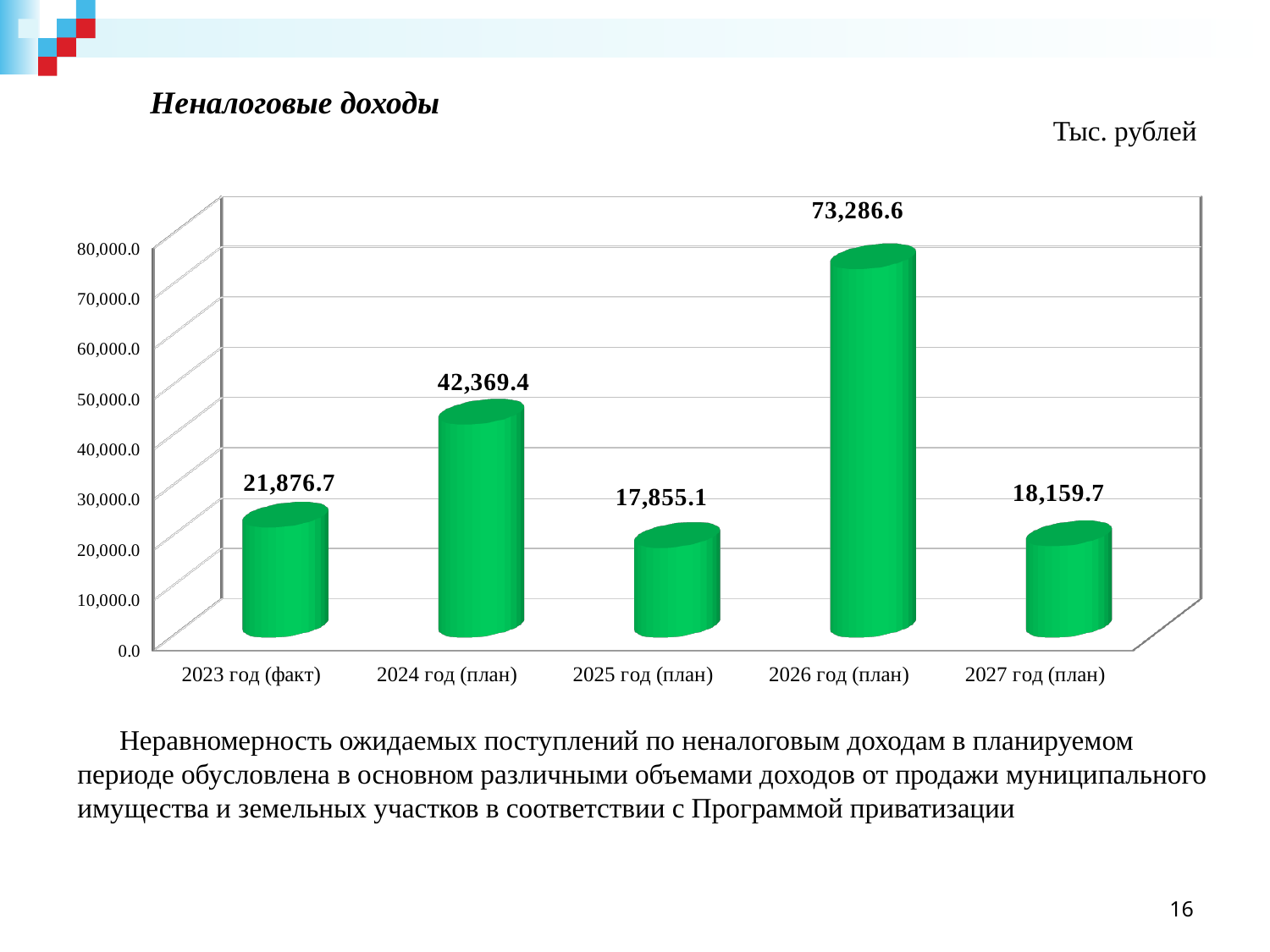
Which category has the lowest value? 2025 год (план) How many categories are shown on the x axis? 5 What is the value for 2025 год (план)? 17,855.1 Is the value for 2024 год (план) greater or less than 40,000.0? greater What is the title of the chart? Неналоговые доходы Which category has the highest value? 2026 год (план) What kind of chart is shown on the slide? bar chart What is the value for 2023 год (факт)? 21,876.7 What is the difference between the values for 2026 год (план) and 2024 год (план)? 30,917.2 Which is larger, the value for 2027 год (план) or 2025 год (план)? 2027 год (план) What is the value for 2026 год (план)? 73,286.6 What is the difference between the values for 2024 год (план) and 2023 год (факт)? 20,492.7